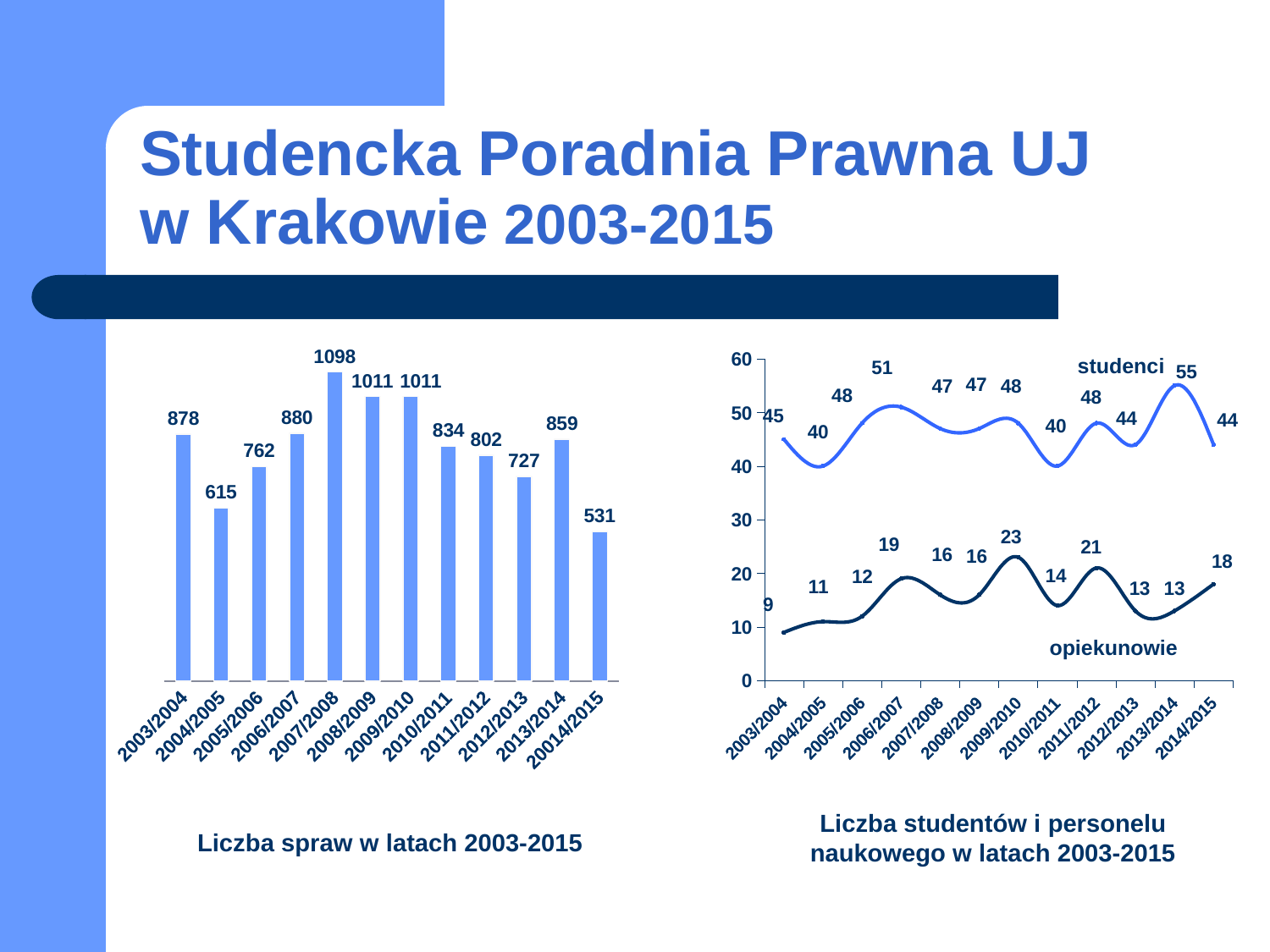
In the chart 'Liczba spraw w latach 2003-2015', what is the difference between the values for 2003/2004 and 2004/2005? 263 In the chart 'Liczba spraw w latach 2003-2015', what is the value for 2007/2008? 1098 In the chart 'Liczba studentów i personelu naukowego w latach 2003-2015', how many series are plotted? 2 In the chart 'Liczba spraw w latach 2003-2015', which year has the lowest value? 20014/2015 What kind of chart is 'Liczba studentów i personelu naukowego w latach 2003-2015'? line chart In the chart 'Liczba studentów i personelu naukowego w latach 2003-2015', what is the value for studenci in 2013/2014? 55 In the chart 'Liczba studentów i personelu naukowego w latach 2003-2015', which year has the lowest value for opiekunowie? 2003/2004 What kind of chart is 'Liczba spraw w latach 2003-2015'? bar chart In the chart 'Liczba studentów i personelu naukowego w latach 2003-2015', what is the value for opiekunowie in 2009/2010? 23 In the chart 'Liczba spraw w latach 2003-2015', which is larger, the value for 2010/2011 or the value for 2013/2014? 2013/2014 In the chart 'Liczba studentów i personelu naukowego w latach 2003-2015', what is the difference between studenci and opiekunowie in 2014/2015? 26 In the chart 'Liczba spraw w latach 2003-2015', how many bars are plotted? 12